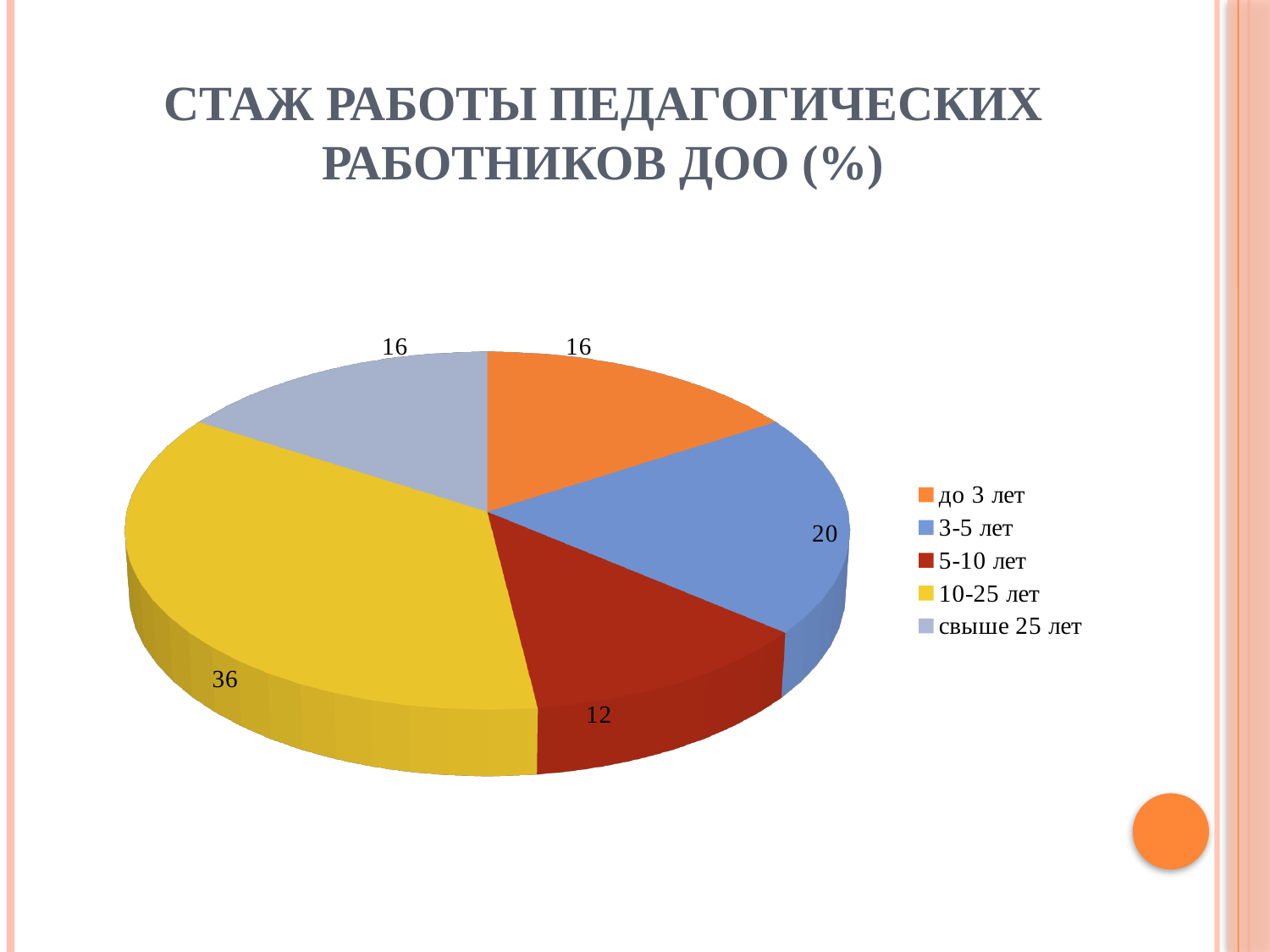
What is the value for the "до 3 лет" slice? 16 How many slices does the pie chart have? 5 What is the value for the "3-5 лет" slice? 20 Which category has the smallest slice of the pie? 5-10 лет Which is larger, the value for "3-5 лет" or the value for "свыше 25 лет"? 3-5 лет Which category has the largest slice of the pie? 10-25 лет What is the value for the "10-25 лет" slice? 36 What kind of chart is shown on the slide? pie chart What is the title of the chart on the slide? Стаж работы педагогических работников ДОО (%) What is the difference between the values for "10-25 лет" and "3-5 лет"? 16 What is the value for the "5-10 лет" slice? 12 What share of the pie does the "10-25 лет" slice represent? 36%